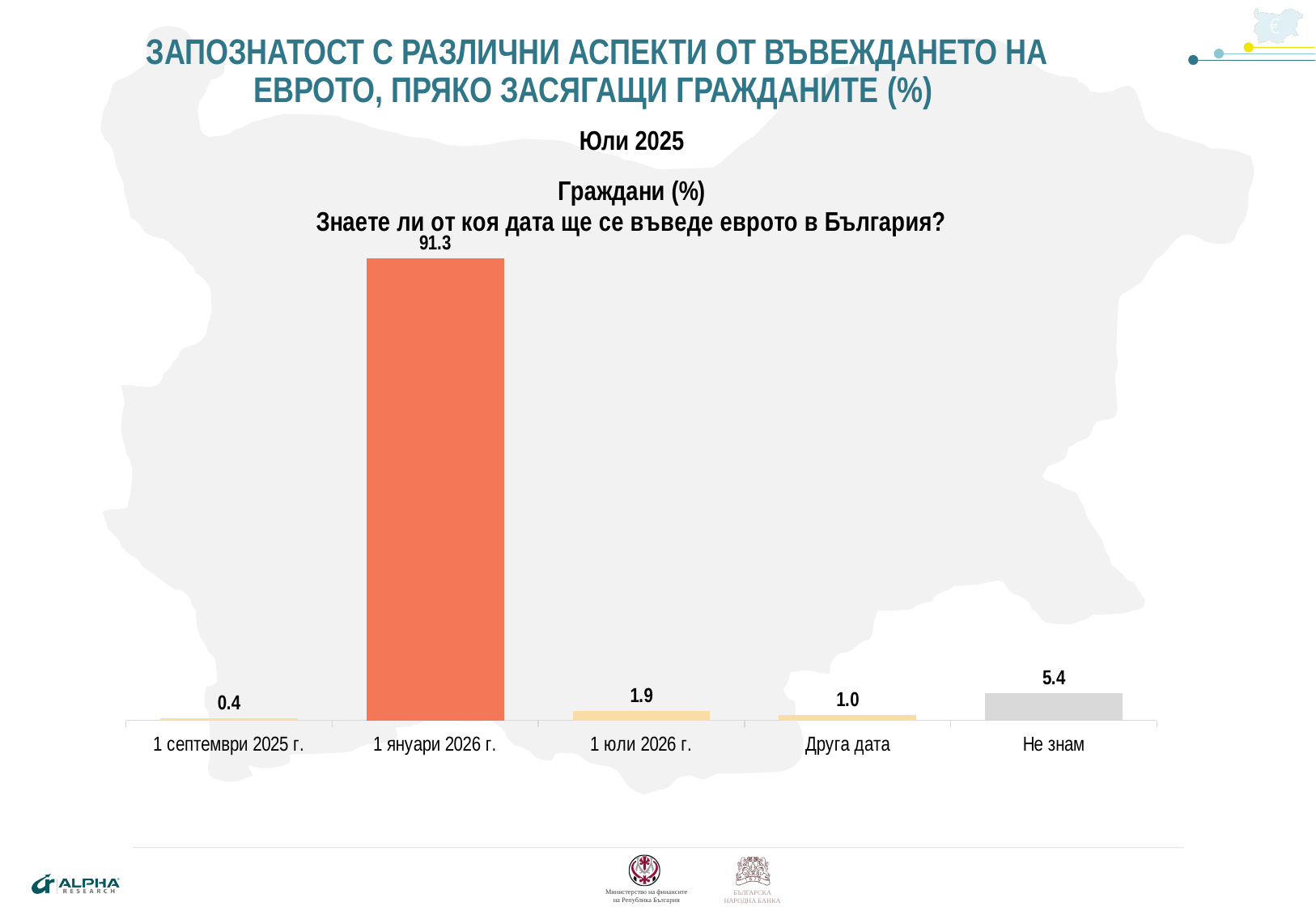
What is the value for "1 януари 2026 г."? 91.3 What is the value for "1 септември 2025 г."? 0.4 Which category has the lowest value? 1 септември 2025 г. What kind of chart is shown on the slide? Bar chart Which is larger, the value for "1 юли 2026 г." or the value for "Друга дата"? 1 юли 2026 г. What question is the chart titled with, below "Граждани (%)"? Знаете ли от коя дата ще се въведе еврото в България? Which category has the highest value? 1 януари 2026 г. What is the value for "Не знам"? 5.4 What is the value for "1 юли 2026 г."? 1.9 What is the difference between the values for "1 януари 2026 г." and "Не знам"? 85.9 How many categories are shown on the x axis? 5 What is the value for "Друга дата"? 1.0